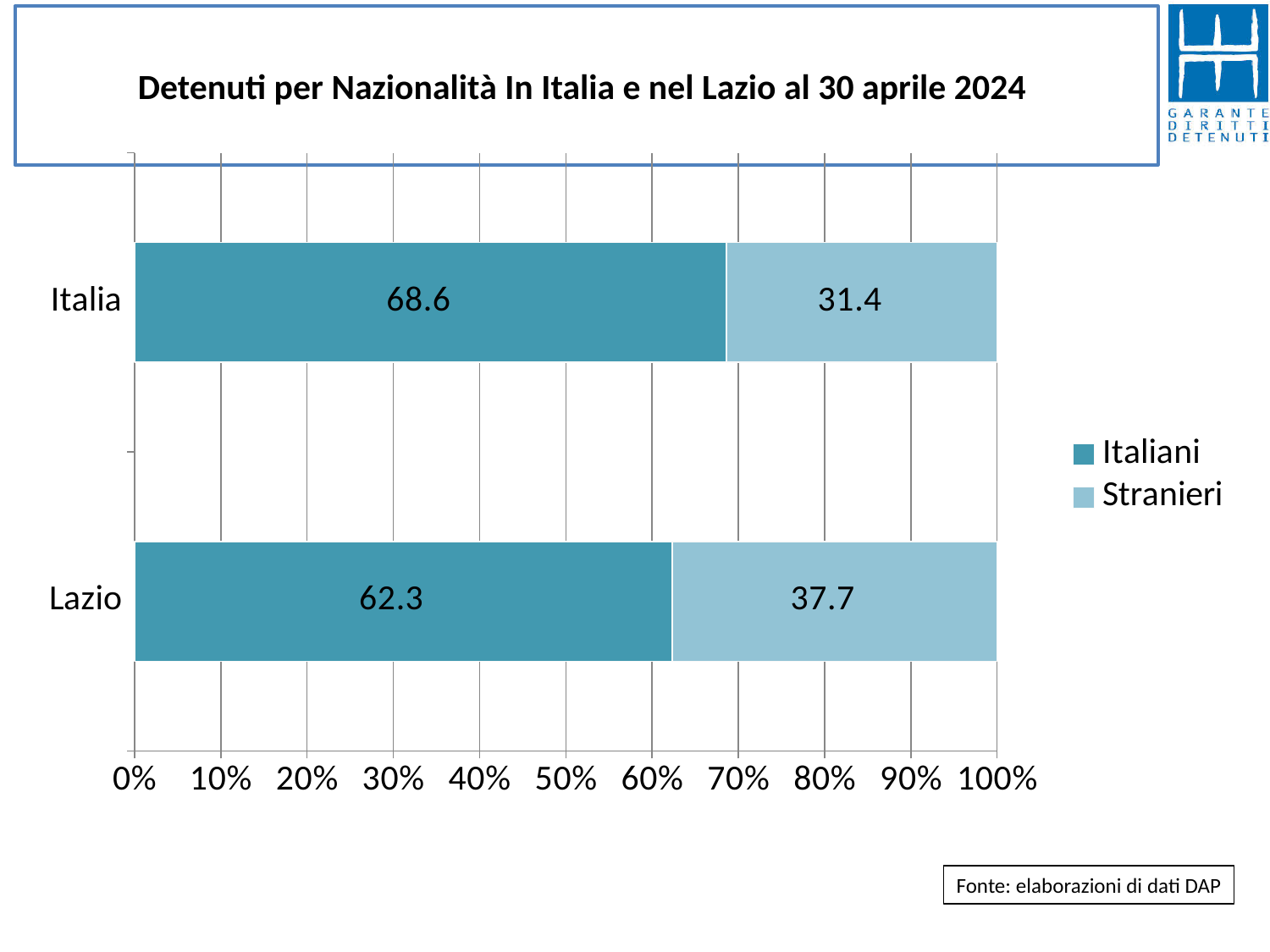
What is the value for Stranieri in Lazio? 37.7 Which category has the higher Stranieri value, Italia or Lazio? Lazio Which category has the higher Italiani value, Italia or Lazio? Italia What is the difference between the Stranieri values for Lazio and Italia? 6.3 What is the value for Stranieri in Italia? 31.4 What kind of chart is shown on the slide? Stacked bar chart How many series does the legend list? 2 What is the value for Italiani in Italia? 68.6 How many categories are shown on the chart? 2 What is the title of the chart? Detenuti per Nazionalità In Italia e nel Lazio al 30 aprile 2024 What is the value for Italiani in Lazio? 62.3 What is the difference between the Italiani values for Italia and Lazio? 6.3